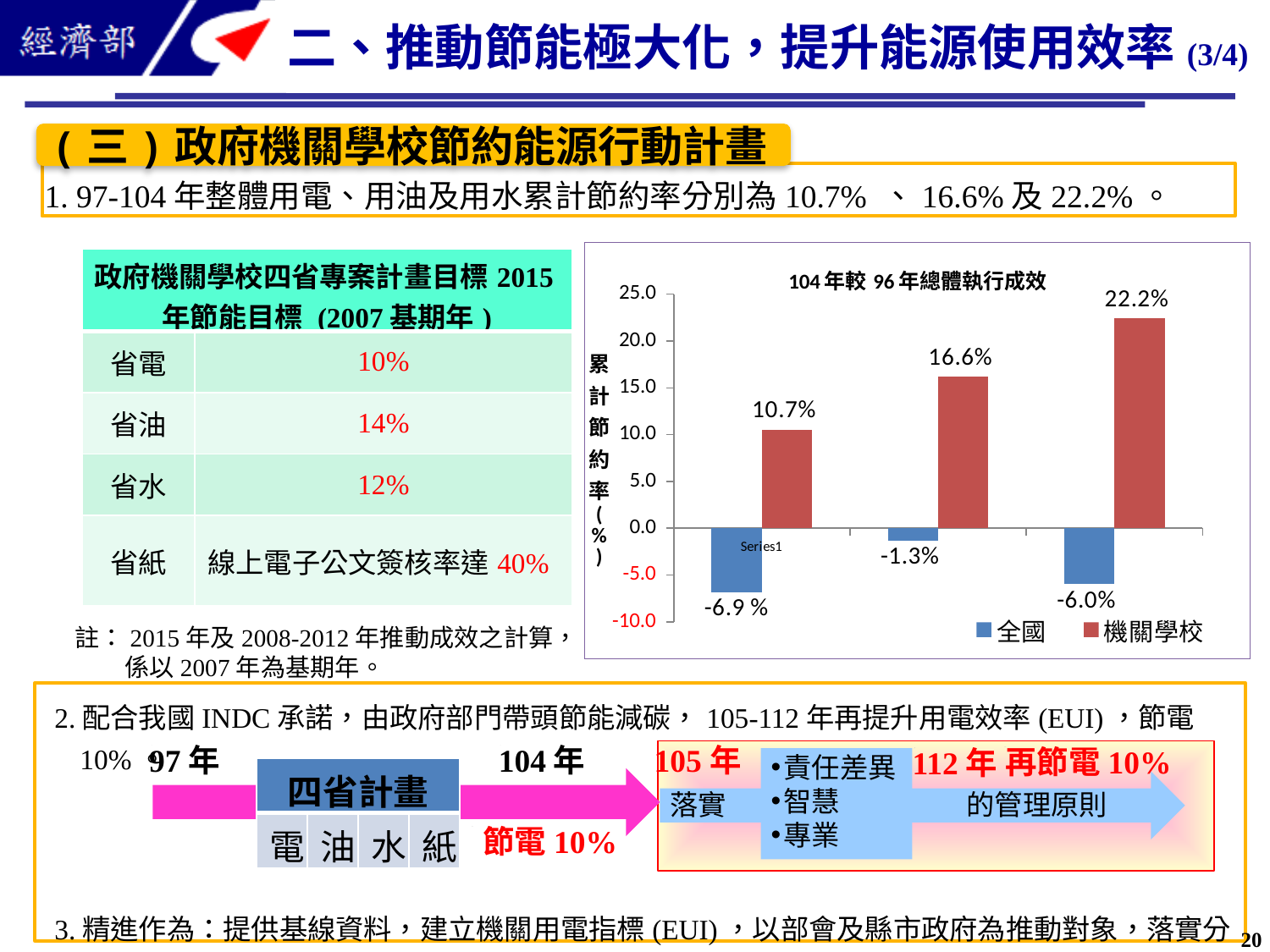
What is the value of the 機關學校 bar in the first group of the chart? 10.7% What is the title of the chart on the slide? 104年較96年總體執行成效 What are the two series named in the chart legend? 全國 and 機關學校 What is the value of the 全國 bar in the second group of the chart? -1.3% What is the value of the 全國 bar in the third group of the chart? -6.0% What is the value of the 機關學校 bar in the third group of the chart? 22.2% How many series does the chart legend list? 2 Which group has the lowest 全國 value in the chart? the first group (-6.9%) What type of chart is shown on the slide? bar chart Which group has the highest 機關學校 value in the chart? the third group (22.2%) How many groups of bars are plotted in the chart? 3 Do the 機關學校 values rise or fall from the first group to the third group? rise